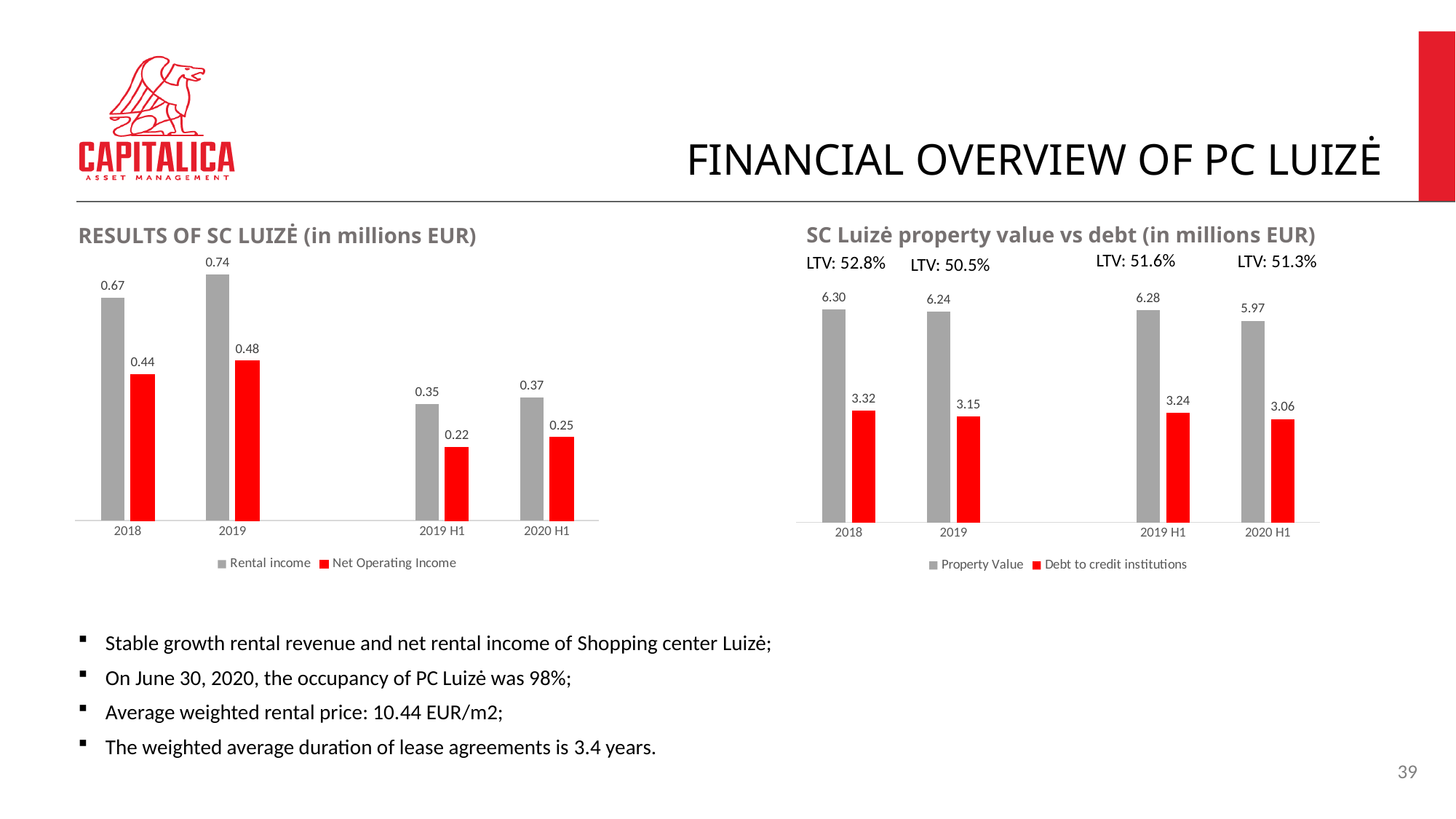
In the 'SC Luizė property value vs debt (in millions EUR)' chart, what is the difference between Property Value and Debt to credit institutions in 2018? 2.98 In the 'RESULTS OF SC LUIZĖ (in millions EUR)' chart, which period has the lowest Net Operating Income? 2019 H1 In the 'RESULTS OF SC LUIZĖ (in millions EUR)' chart, what is the Rental income for 2019? 0.74 In the 'RESULTS OF SC LUIZĖ (in millions EUR)' chart, how many series does the legend list? 2 In the 'SC Luizė property value vs debt (in millions EUR)' chart, how many periods are shown on the x axis? 4 What type of chart is the 'SC Luizė property value vs debt (in millions EUR)' chart? Bar chart In the 'RESULTS OF SC LUIZĖ (in millions EUR)' chart, which period has the highest Rental income? 2019 In the 'SC Luizė property value vs debt (in millions EUR)' chart, which period has the lowest Property Value? 2020 H1 In the 'RESULTS OF SC LUIZĖ (in millions EUR)' chart, what is the difference between Rental income and Net Operating Income in 2018? 0.23 In the 'RESULTS OF SC LUIZĖ (in millions EUR)' chart, what is the Net Operating Income for 2020 H1? 0.25 In the 'SC Luizė property value vs debt (in millions EUR)' chart, what is the Debt to credit institutions for 2020 H1? 3.06 In the 'SC Luizė property value vs debt (in millions EUR)' chart, what is the Property Value for 2019 H1? 6.28